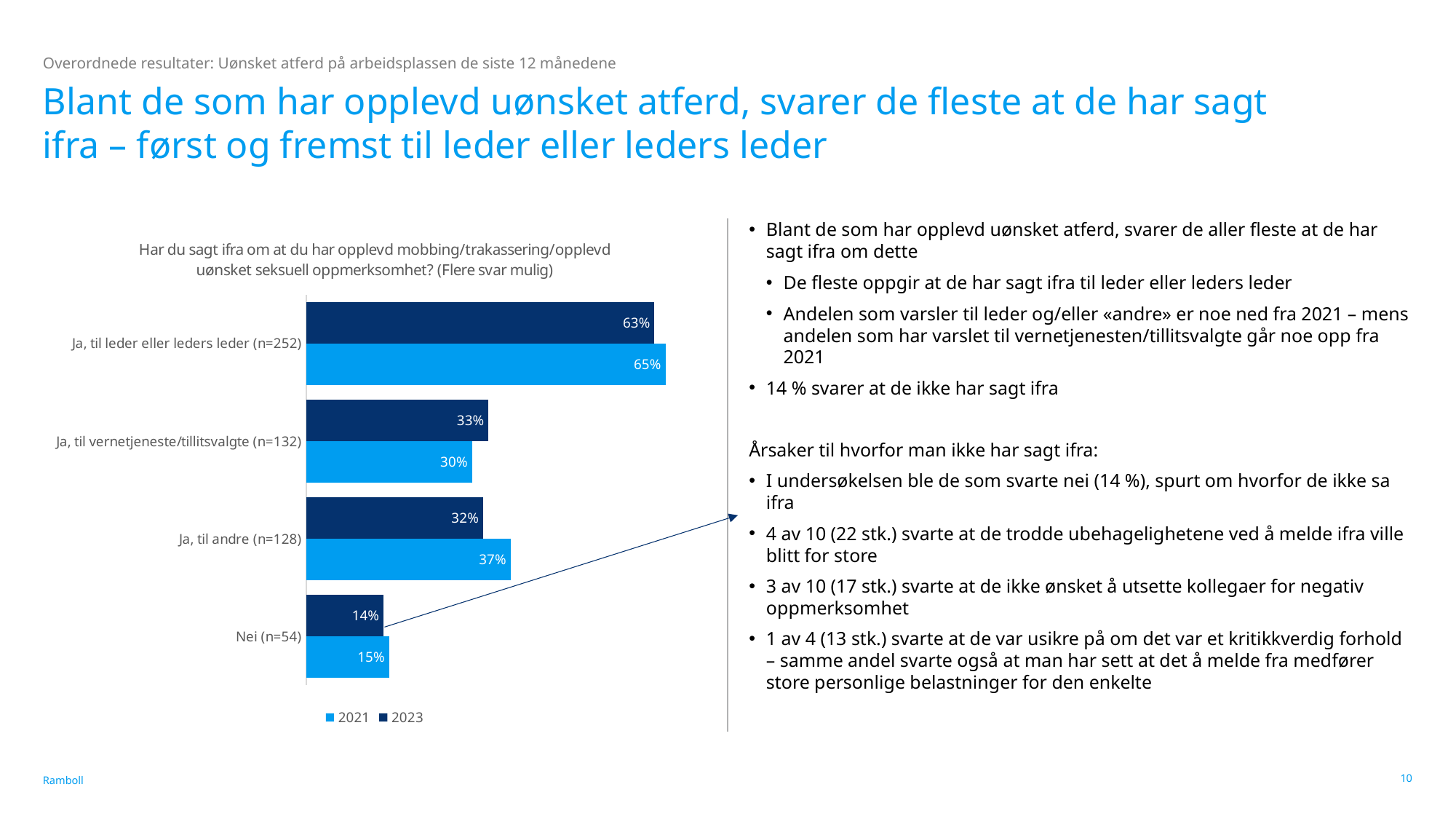
What is the 2023 value for "Ja, til vernetjeneste/tillitsvalgte (n=132)"? 33% Which category has the highest 2021 value? Ja, til leder eller leders leder (n=252) For "Ja, til vernetjeneste/tillitsvalgte (n=132)", which year has the larger value, 2021 or 2023? 2023 What is the 2021 value for "Ja, til leder eller leders leder (n=252)"? 65% What is the 2023 value for "Ja, til leder eller leders leder (n=252)"? 63% How many response categories are shown in the chart? 4 What is the 2021 value for "Ja, til andre (n=128)"? 37% What kind of chart is shown on the slide? Bar chart How many series does the chart legend list? 2 What is the difference between the 2021 and 2023 values for "Ja, til andre (n=128)"? 5 percentage points What is the 2023 value for "Nei (n=54)"? 14% Which category has the lowest 2023 value? Nei (n=54)